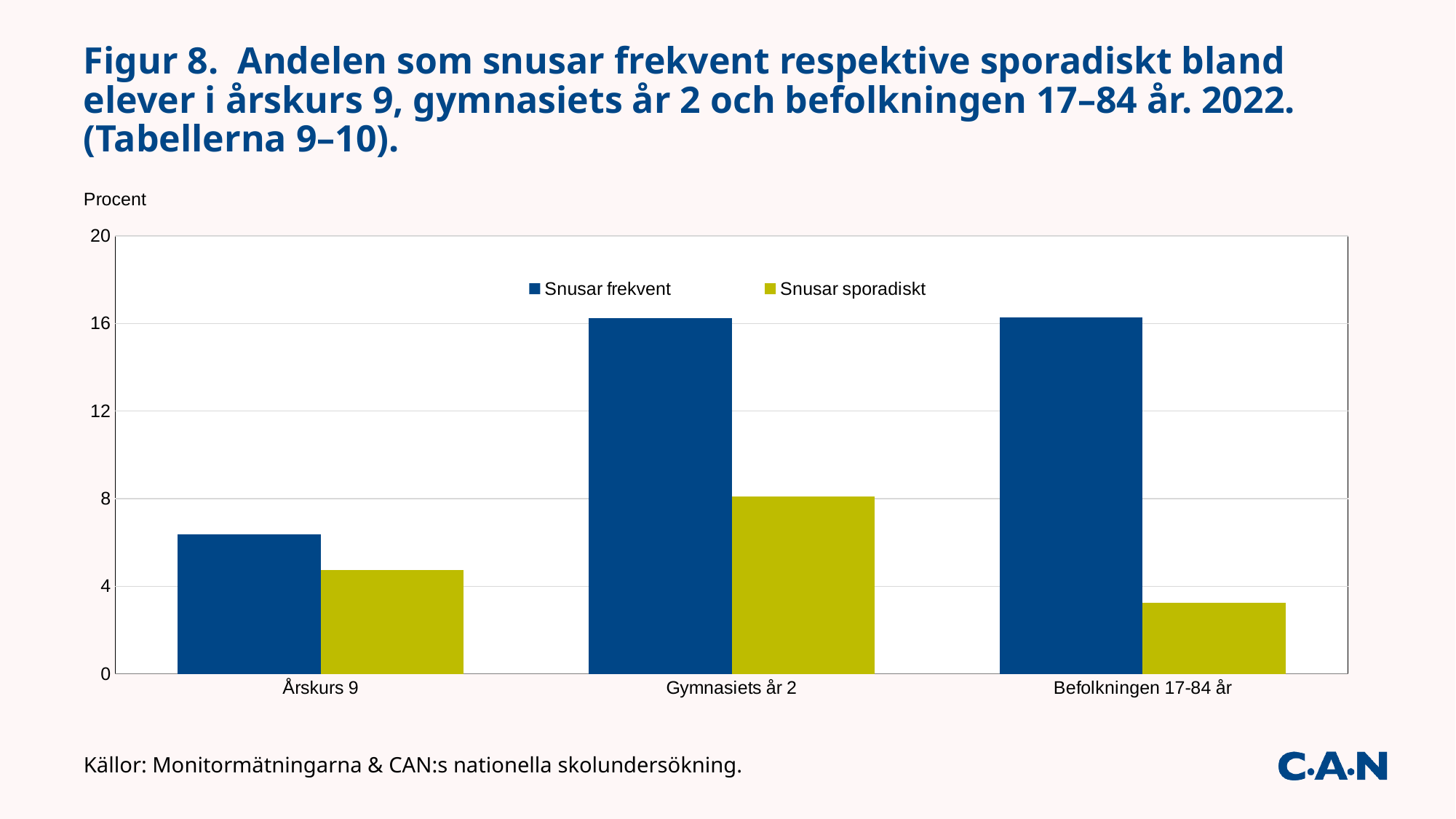
For Befolkningen 17-84 år, which is larger: Snusar frekvent or Snusar sporadiskt? Snusar frekvent Which category has the highest value for Snusar sporadiskt? Gymnasiets år 2 What kind of chart is shown on the slide? bar chart Which category has the lowest value for Snusar frekvent? Årskurs 9 Is the value for Snusar frekvent in Årskurs 9 greater or less than 8? less How many series does the legend list? 2 Which category has the lowest value for Snusar sporadiskt? Befolkningen 17-84 år What is the label on the y axis of the chart? Procent Is the value for Snusar sporadiskt in Befolkningen 17-84 år greater or less than 4? less How many categories are shown on the x axis? 3